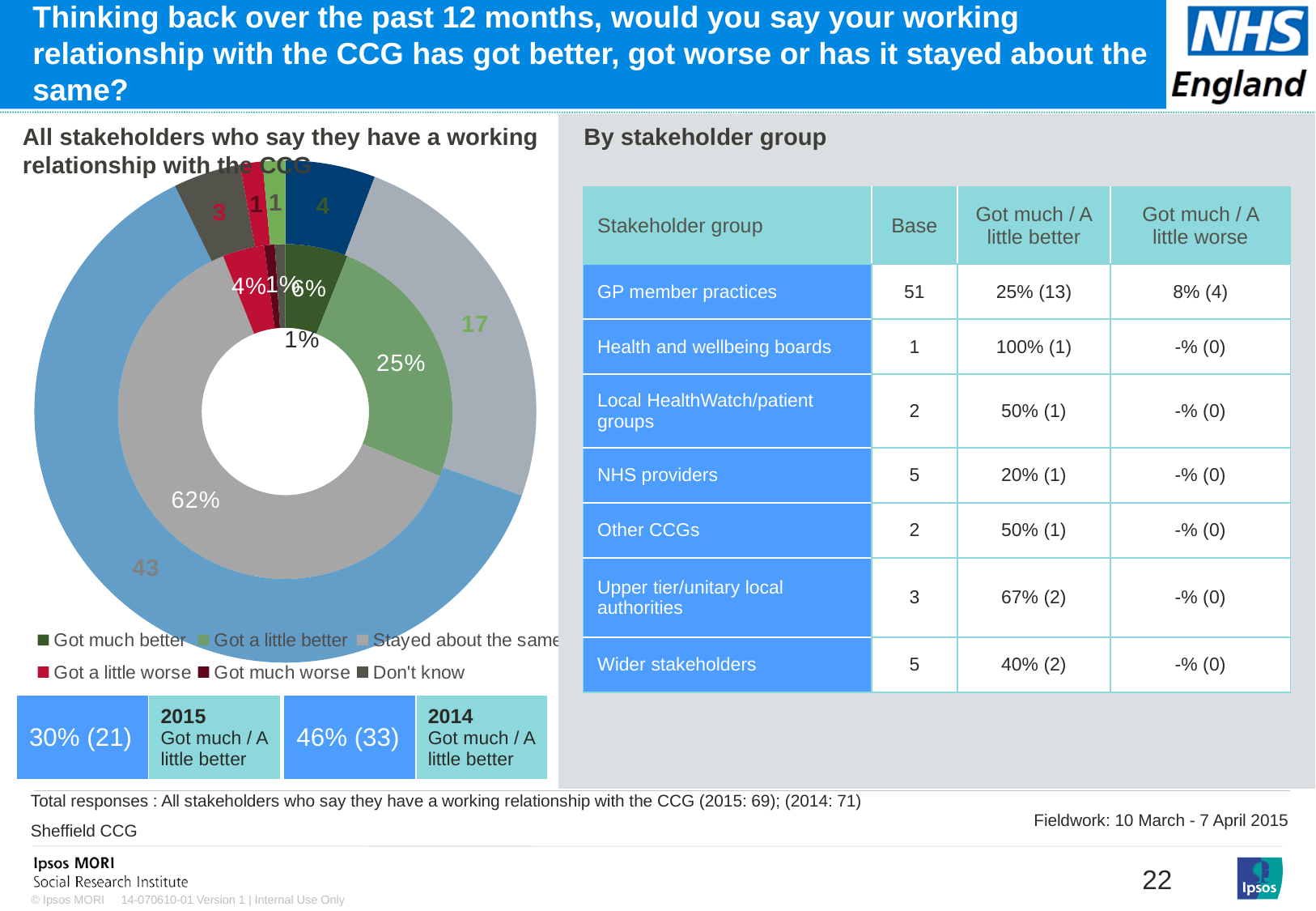
In the doughnut chart, what percentage of stakeholders said their relationship 'Stayed about the same'? 62% In the doughnut chart, what percentage of stakeholders said their relationship 'Got a little better'? 25% In the doughnut chart, what percentage of stakeholders said their relationship 'Got much better'? 6% Which category has the largest share in the doughnut chart? Stayed about the same What share of the doughnut chart does 'Stayed about the same' take up? 62% What type of chart is shown on the left of the slide? Doughnut (pie) chart What is the title of the doughnut chart on the left of the slide? All stakeholders who say they have a working relationship with the CCG Which is larger in the doughnut chart: 'Got a little better' or 'Got much better'? Got a little better What is the largest count label shown on the outer ring of the doughnut chart? 43 In the doughnut chart, what percentage of stakeholders said their relationship 'Got a little worse'? 4% How many categories does the legend of the doughnut chart list? 6 What is the difference in percentage points between 'Stayed about the same' and 'Got a little better' in the doughnut chart? 37 percentage points